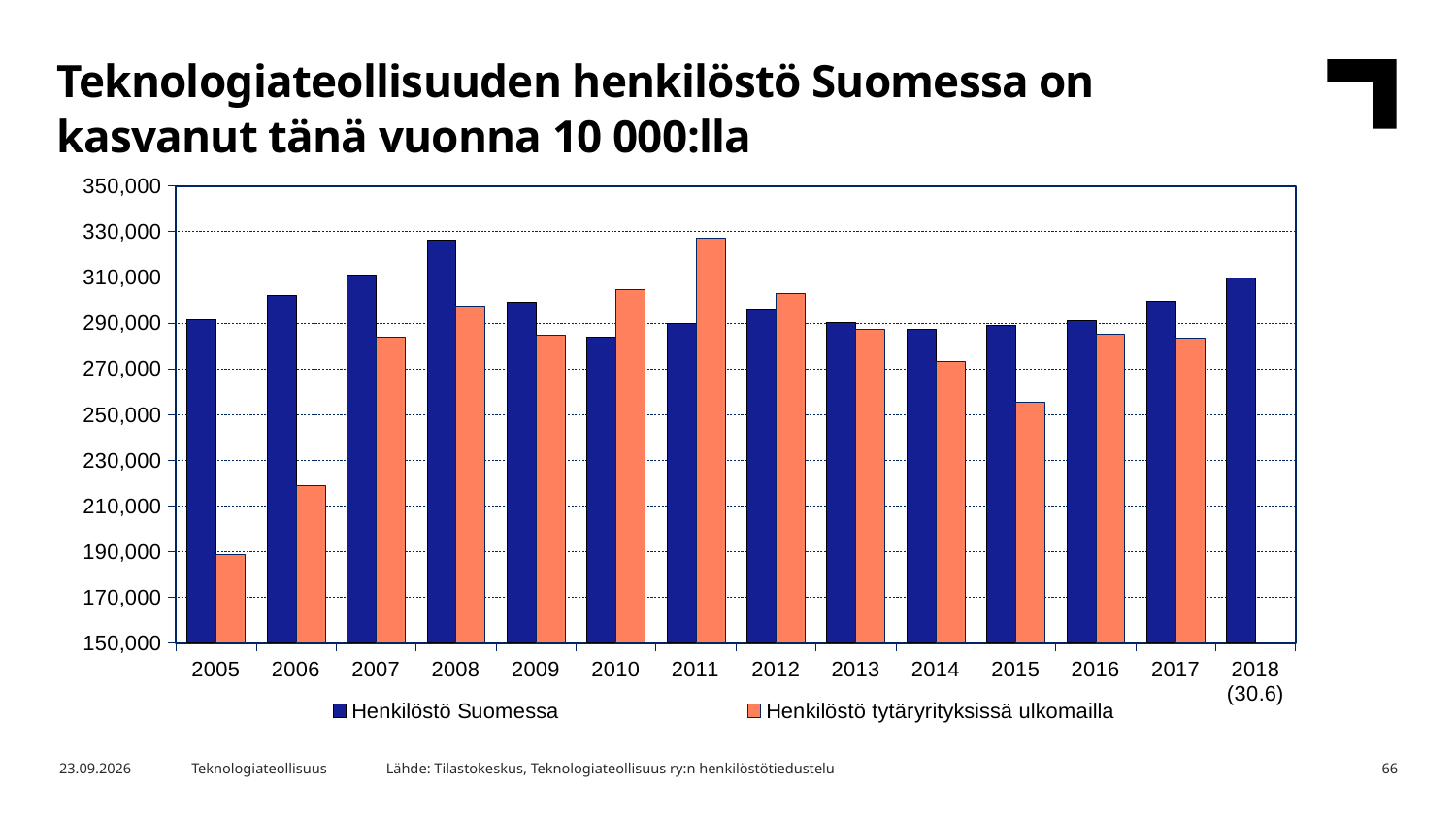
In which year is the value for Henkilöstö tytäryrityksissä ulkomailla lowest? 2005 How many series does the legend list? 2 In 2015, which series has the larger value: Henkilöstö Suomessa or Henkilöstö tytäryrityksissä ulkomailla? Henkilöstö Suomessa Is the value for Henkilöstö tytäryrityksissä ulkomailla in 2006 greater or less than 230,000? less In 2011, which series has the larger value: Henkilöstö Suomessa or Henkilöstö tytäryrityksissä ulkomailla? Henkilöstö tytäryrityksissä ulkomailla Is the value for Henkilöstö Suomessa in 2008 greater or less than 310,000? greater What kind of chart is shown on the slide? bar chart How many year categories are shown on the x axis? 14 Does the value for Henkilöstö tytäryrityksissä ulkomailla rise or fall from 2005 to 2008? rise In which year is the value for Henkilöstö Suomessa highest? 2008 Is the value for Henkilöstö Suomessa in 2018 (30.6) greater or less than 290,000? greater In which year is the value for Henkilöstö tytäryrityksissä ulkomailla highest? 2011